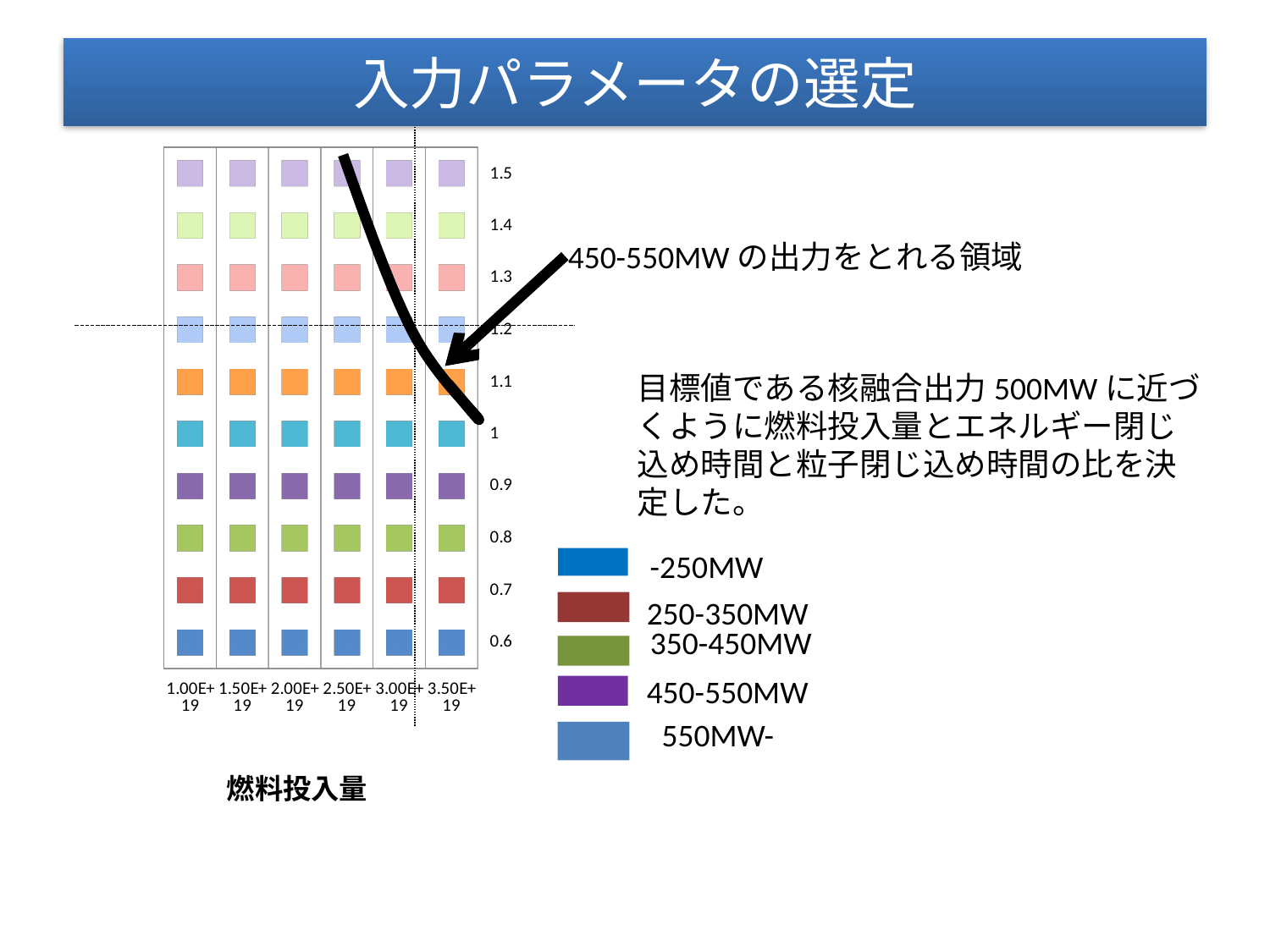
What is the rightmost category label on the x axis of the chart? 3.50E+19 How many entries does the legend of the chart list? 5 How many categories are shown along the x axis of the chart? 6 How many distinct values are labelled on the y axis of the chart? 10 What is the leftmost category label on the x axis of the chart? 1.00E+19 What is the lowest value labelled on the y axis of the chart? 0.6 What is the highest value labelled on the y axis of the chart? 1.5 Which legend entry corresponds to the lowest output range? -250MW Which legend entry corresponds to the highest output range? 550MW- How many coloured markers are plotted in the chart in total? 60 What is the x-axis title of the chart? 燃料投入量 What is the first entry listed in the chart's legend? -250MW